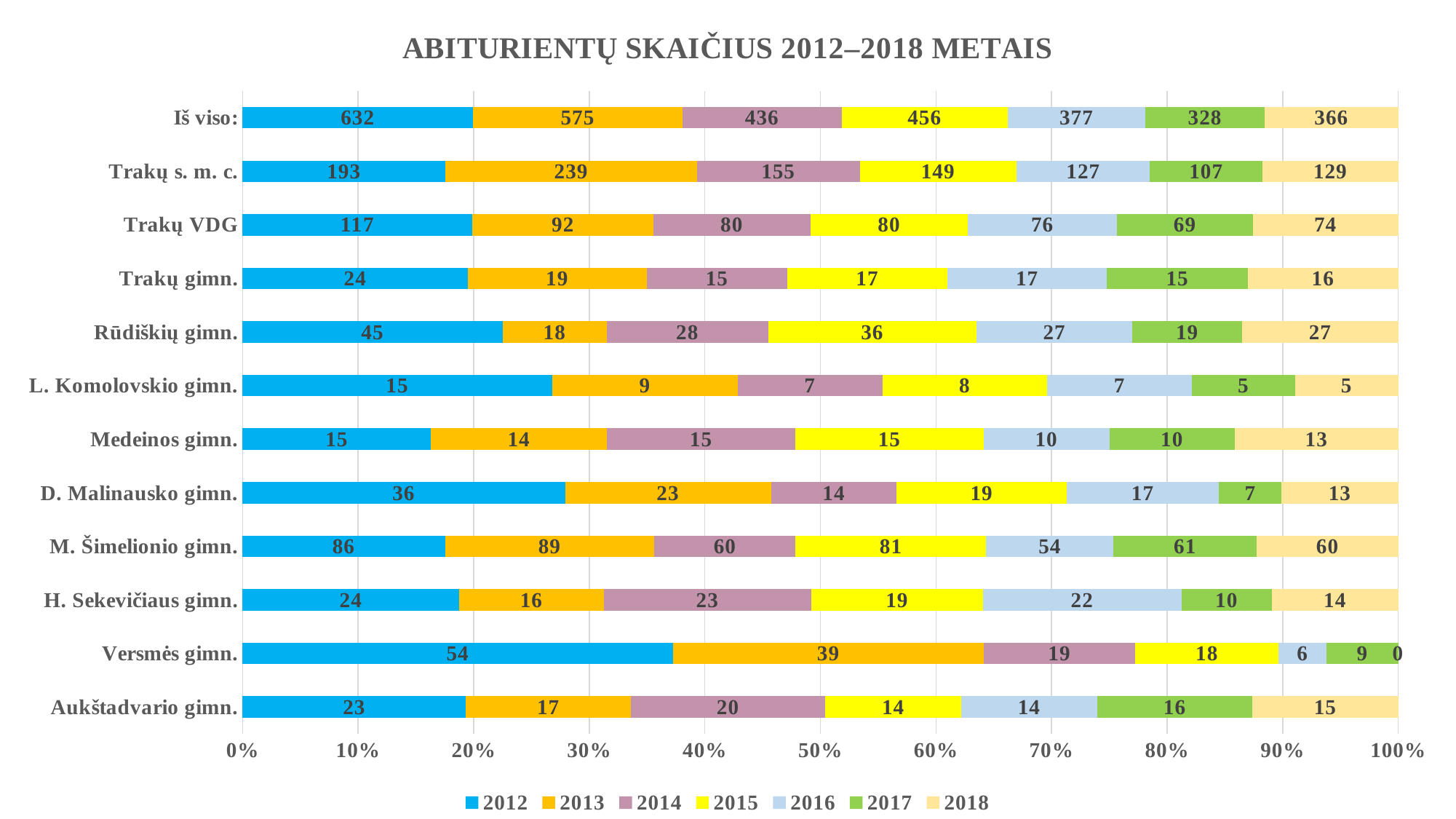
What is the difference between the 2012 and 2013 values for Iš viso? 57 For Rūdiškių gimn., which is larger: the 2012 value or the 2014 value? 2012 What kind of chart is this? Stacked bar chart How many series does the legend list? 7 What is the value for Trakų VDG in 2012? 117 In the Iš viso row, which year has the highest value? 2012 How many categories (rows) are shown on the chart? 12 What is the value for M. Šimelionio gimn. in 2013? 89 What is the value for Versmės gimn. in 2018? 0 What is the value for Rūdiškių gimn. in 2015? 36 What is the total of all values in the Trakų gimn. bar? 123 In the Iš viso row, which year has the lowest value? 2017